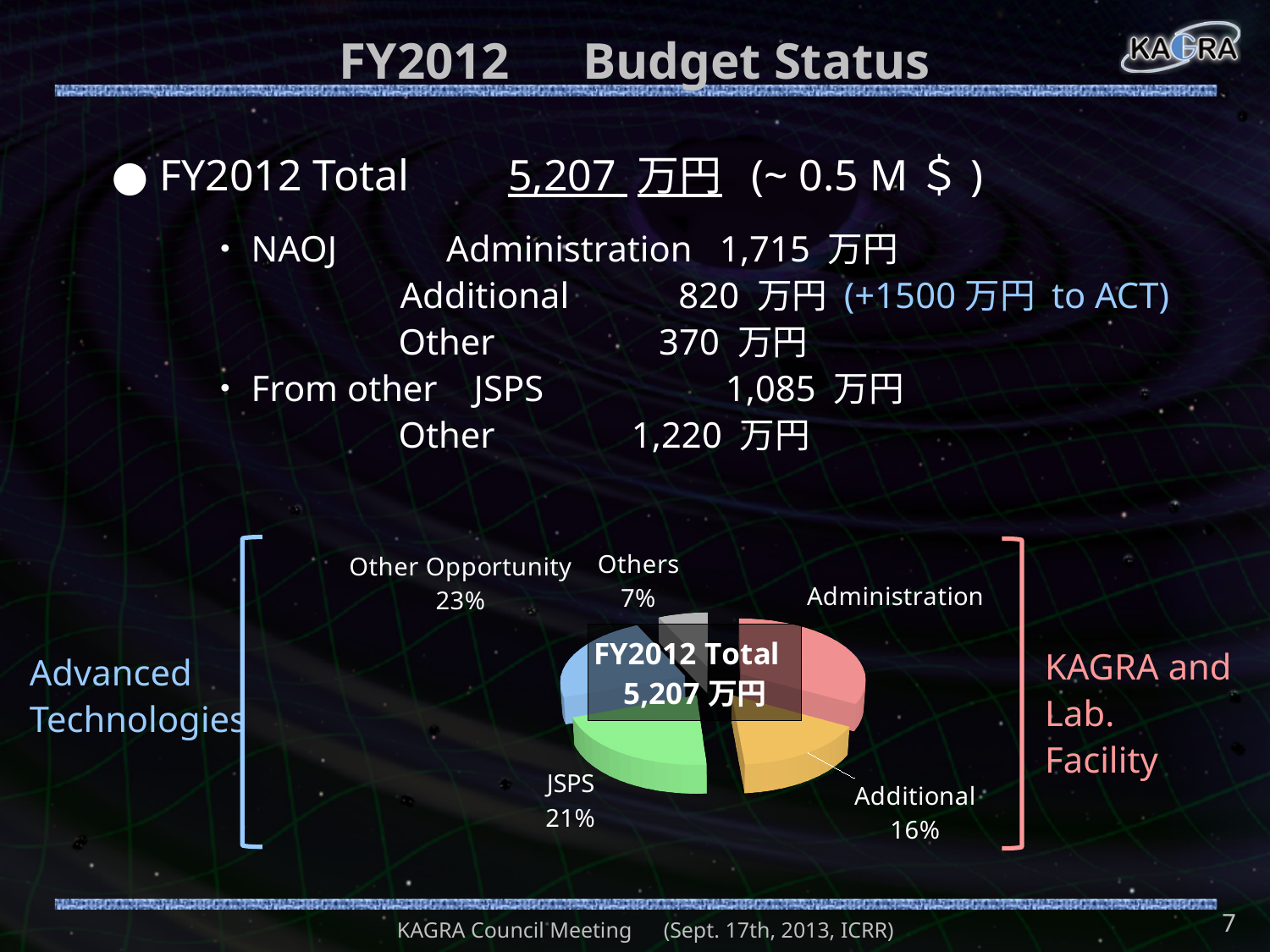
Which slice of the pie chart is the largest? Administration What percentage of the pie chart is labelled for Additional? 16% What percentage of the pie chart is labelled for Other Opportunity? 23% What is the difference in percentage points between the Other Opportunity slice and the JSPS slice? 2 What total is printed in the centre of the pie chart? FY2012 Total 5,207 万円 What percentage of the pie chart is labelled for Others? 7% What percentage of the pie chart is labelled for JSPS? 21% What kind of chart is shown on the slide? pie chart Which slice of the pie chart is the smallest? Others How many slices does the pie chart have? 5 Which is larger in the pie chart, the JSPS slice or the Additional slice? JSPS